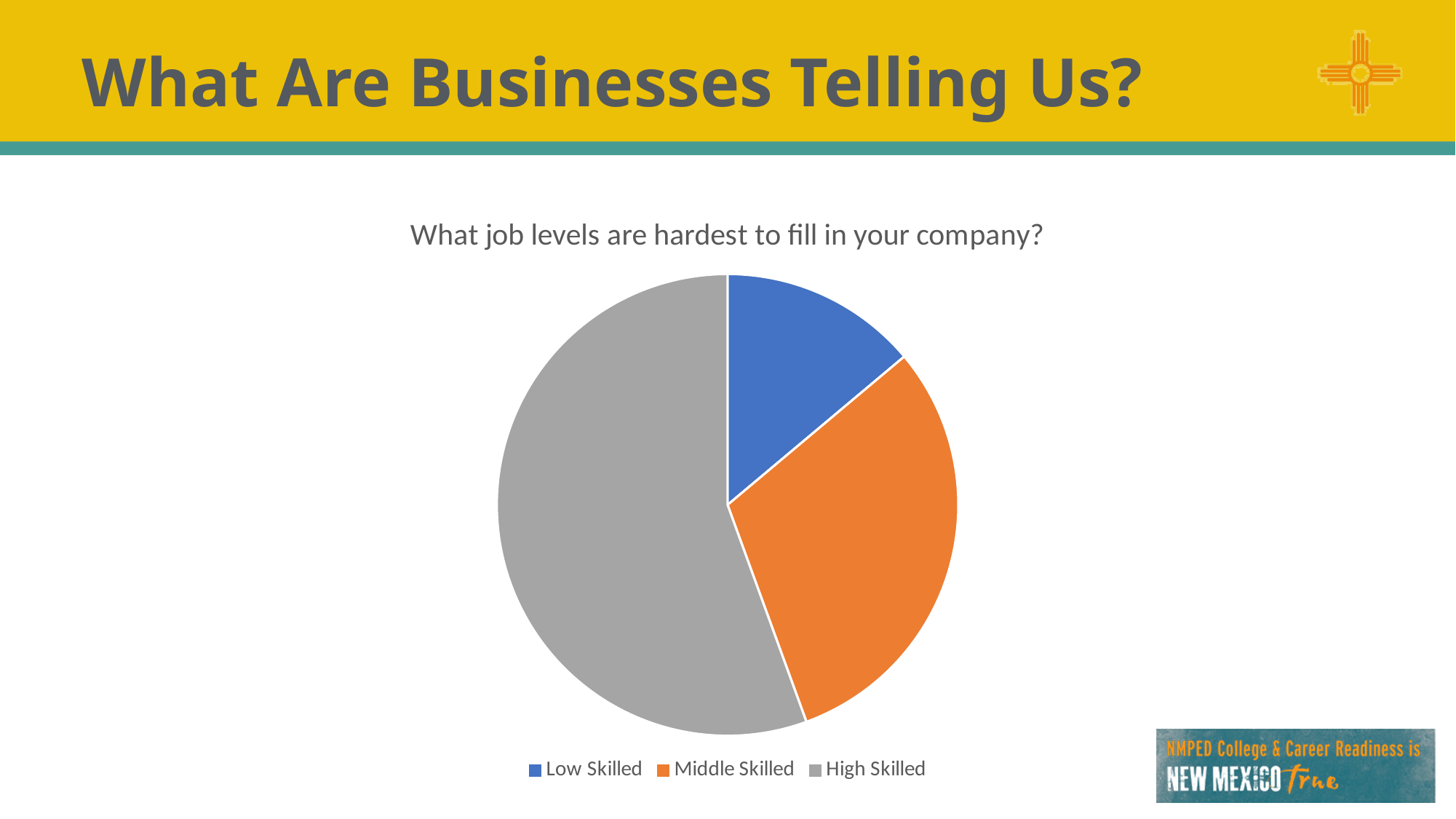
Which job level has the smallest slice of the pie? Low Skilled Which slice is larger, High Skilled or Middle Skilled? High Skilled Which slice is larger, Middle Skilled or Low Skilled? Middle Skilled How many slices does the pie chart have? 3 Which job level has the largest slice of the pie? High Skilled What kind of chart is shown on the slide? pie chart What is the title of the chart? What job levels are hardest to fill in your company? Which colour represents the Middle Skilled slice? orange How many entries does the legend list? 3